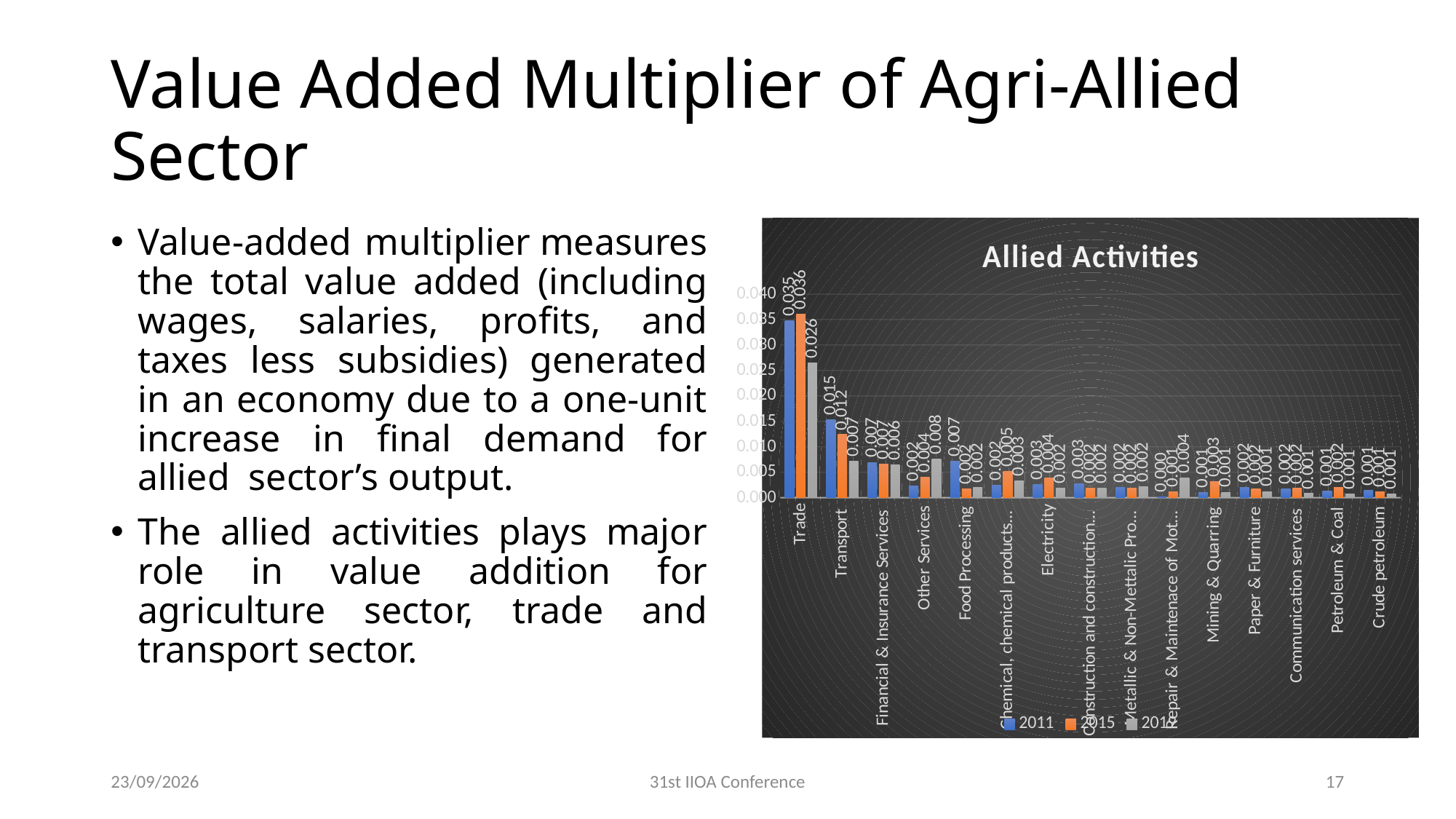
What is the difference between the 2015 values for Trade and Transport? 0.024 What is the 2011 value for Transport? 0.015 Is the 2015 value for Trade greater or less than 0.030? greater Which is larger, the 2011 value for Trade or the 2011 value for Transport? Trade What is the 2011 value for Trade? 0.035 What is the 2015 value for Trade? 0.036 What is the 2011 value for Food Processing? 0.007 How many series does the chart's legend list? 3 How many categories are shown on the x axis of the chart? 15 What is the title of the chart? Allied Activities Which category has the highest 2011 value? Trade What kind of chart is shown on the slide? bar chart